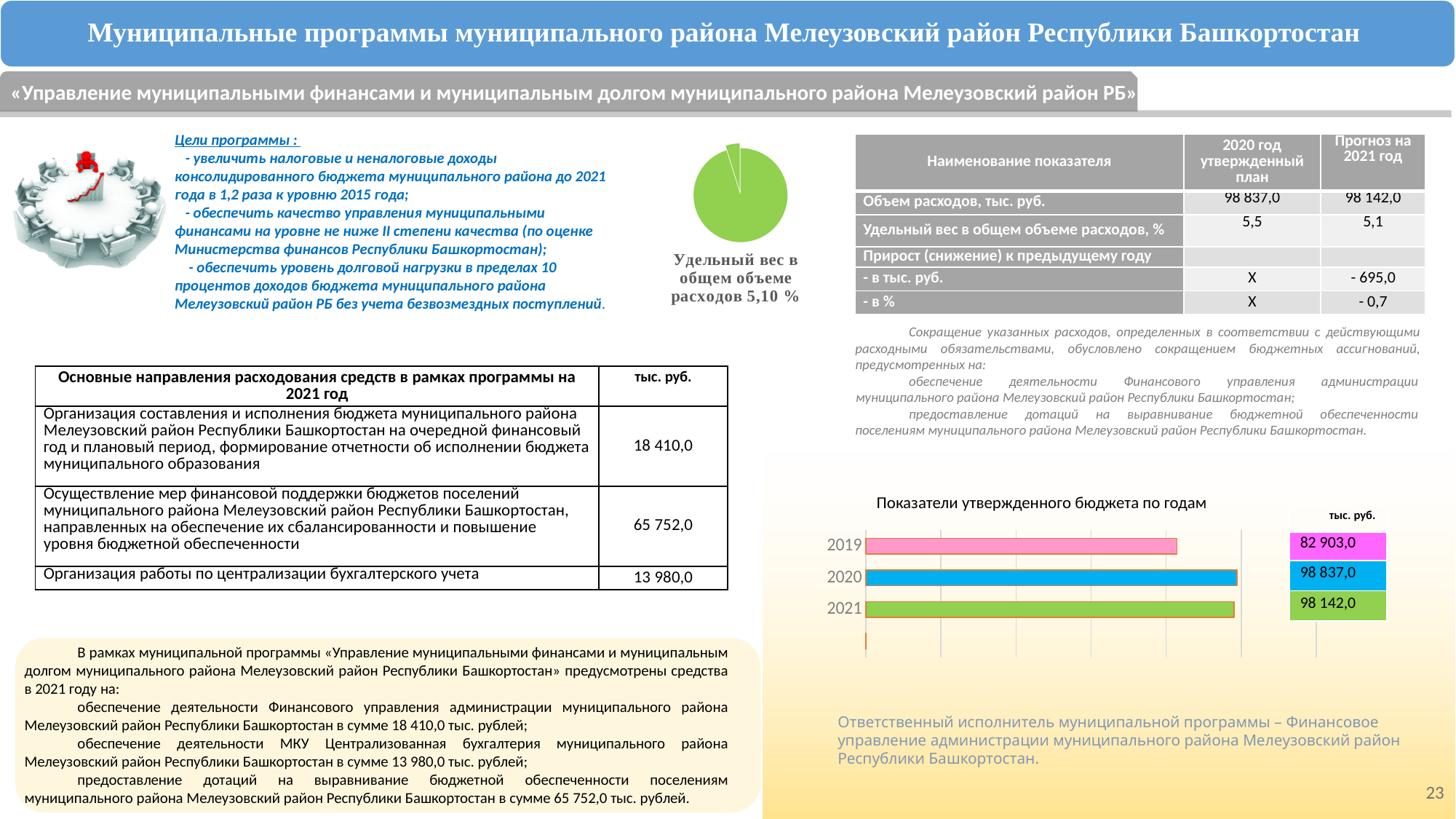
In the chart «Показатели утвержденного бюджета по годам», what is the value for 2021? 98 142,0 What kind of chart is the green chart in the upper middle of the slide, labelled «Удельный вес в общем объеме расходов»? pie chart In the chart «Показатели утвержденного бюджета по годам», which year has the lowest value? 2019 In the chart «Показатели утвержденного бюджета по годам», what is the difference between the values for 2020 and 2019? 15 934,0 In the chart «Показатели утвержденного бюджета по годам», which year has the highest value? 2020 What kind of chart is the chart titled «Показатели утвержденного бюджета по годам»? bar chart In the chart «Показатели утвержденного бюджета по годам», what is the difference between the values for 2020 and 2021? 695,0 In the chart «Показатели утвержденного бюджета по годам», what is the value for 2020? 98 837,0 In the chart «Показатели утвержденного бюджета по годам», does the value rise or fall from 2019 to 2020? rise How many years are plotted in the chart «Показатели утвержденного бюджета по годам»? 3 In the chart «Показатели утвержденного бюджета по годам», which is larger, the value for 2020 or the value for 2021? 2020 In the chart «Показатели утвержденного бюджета по годам», what is the value for 2019? 82 903,0